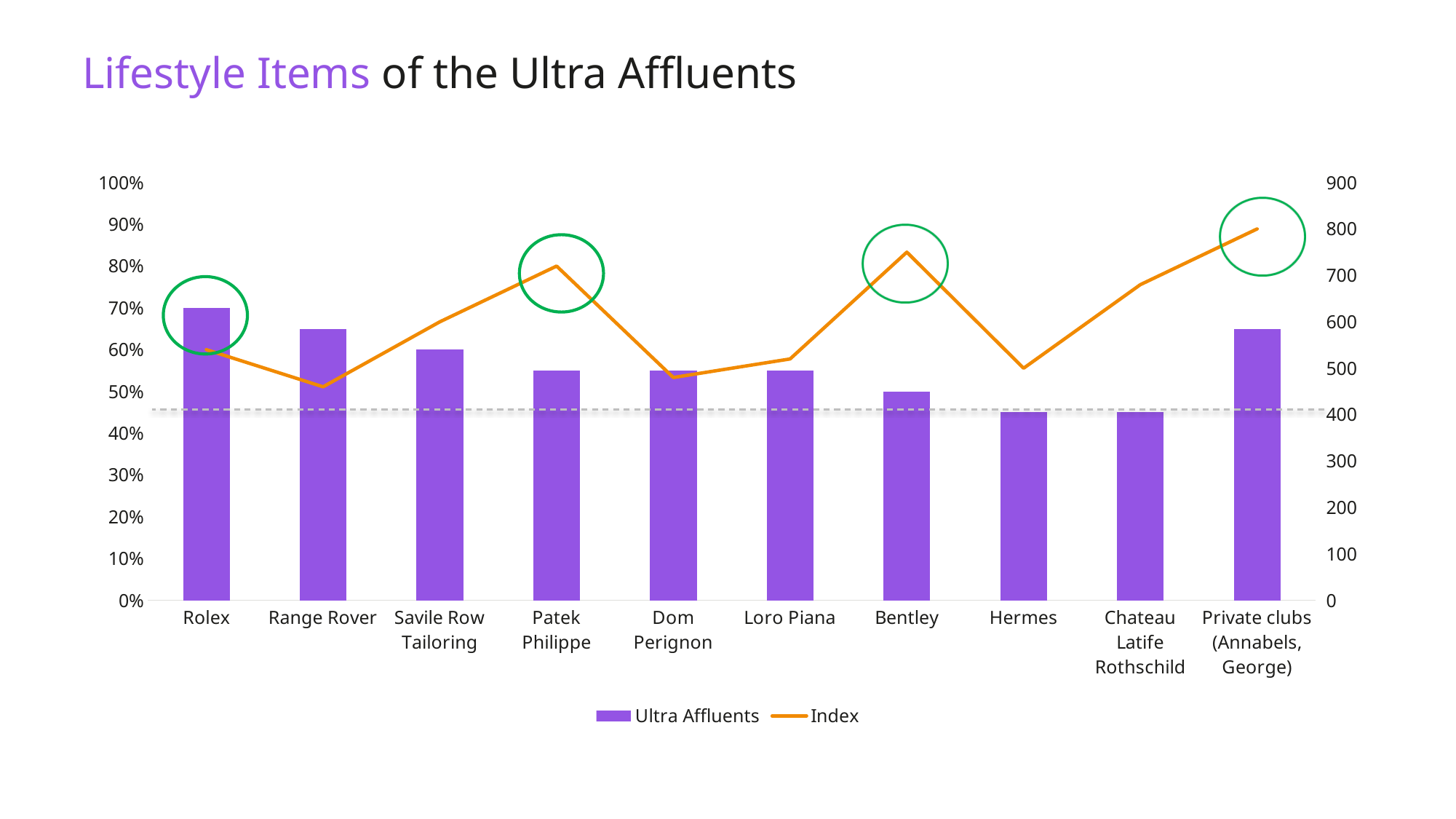
Is the Index value for Range Rover greater or less than 500? less Is the Index value for Patek Philippe greater or less than 600? greater What are the two series named in the legend? Ultra Affluents and Index Which has the larger Index value, Bentley or Hermes? Bentley Which lifestyle item has the highest Index value? Private clubs (Annabels, George) Which has the larger Ultra Affluents bar, Rolex or Range Rover? Rolex Is the Ultra Affluents value for Hermes greater or less than 50%? less How many series does the legend list? 2 Which lifestyle item has the highest Ultra Affluents bar? Rolex What kind of chart is shown on the slide? Combination bar and line chart How many lifestyle items (categories) are shown on the x axis? 10